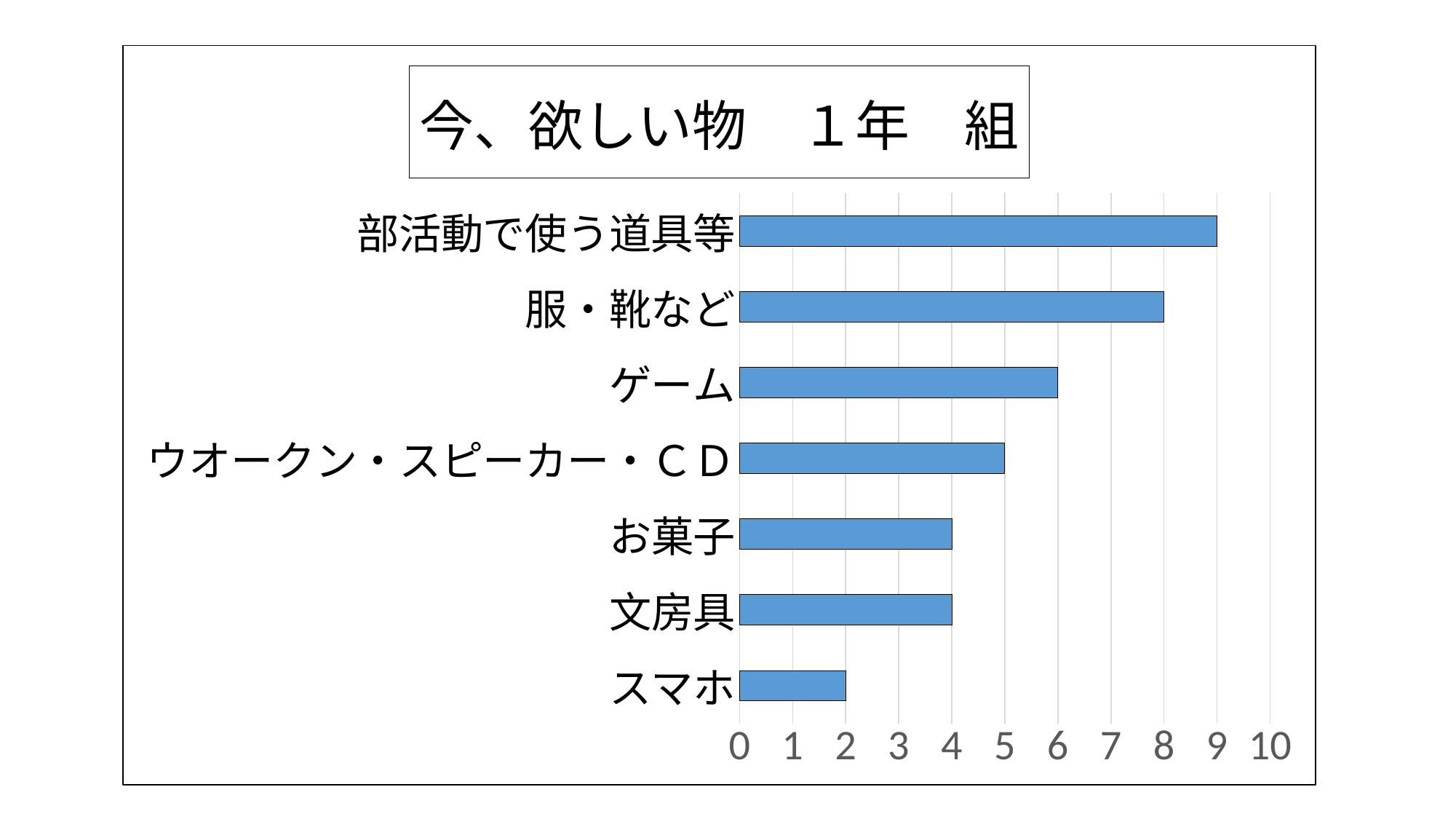
What is the title of the chart? 今、欲しい物 １年 組 Which category has the lowest value? スマホ What kind of chart is shown on the slide? Bar chart What is the value for 部活動で使う道具等? 9 What is the value for 服・靴など? 8 Which category has the highest value? 部活動で使う道具等 What is the difference between the values for 部活動で使う道具等 and スマホ? 7 Which is larger, the value for ゲーム or the value for お菓子? ゲーム What is the value for スマホ? 2 How many categories are shown in the chart? 7 Is the value for ウオークン・スピーカー・ＣＤ greater or less than 4? greater What is the value for ゲーム? 6